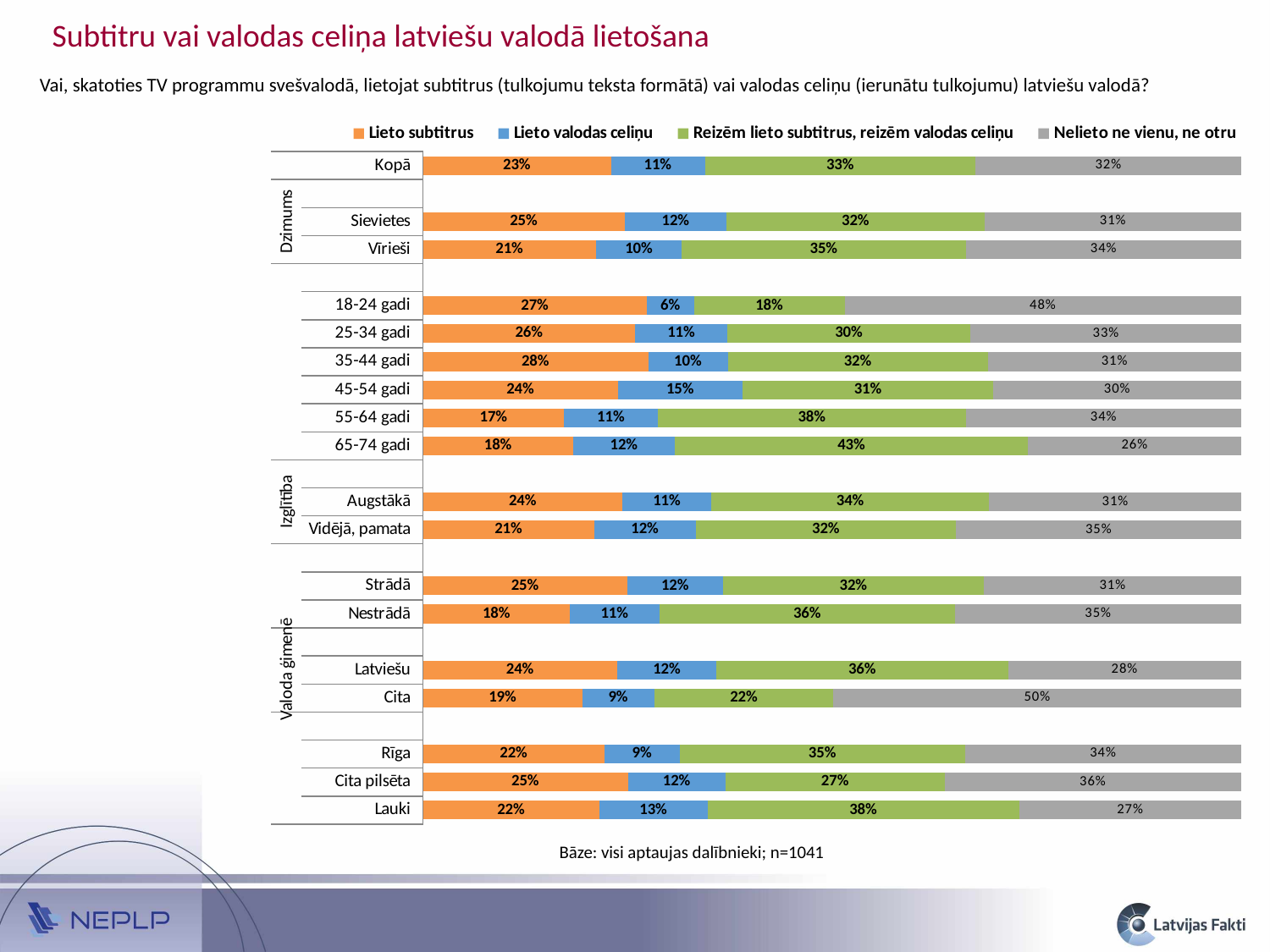
What is the value of 'Reizēm lieto subtitrus, reizēm valodas celiņu' for 65-74 gadi? 43% What kind of chart is shown on the slide? Stacked bar chart Which is larger: 'Reizēm lieto subtitrus, reizēm valodas celiņu' for Lauki or for Cita pilsēta? Lauki What is the first series listed in the legend? Lieto subtitrus Which category has the lowest value for 'Lieto valodas celiņu'? 18-24 gadi How many series does the legend list? 4 Which category has the highest value for 'Lieto subtitrus'? 35-44 gadi What is the value of 'Lieto subtitrus' for Kopā? 23% What is the value of 'Nelieto ne vienu, ne otru' for 18-24 gadi? 48% What is the value of 'Lieto valodas celiņu' for 45-54 gadi? 15% What is the difference between the 'Lieto subtitrus' values for Sievietes and Vīrieši? 4% Which category has the highest value for 'Nelieto ne vienu, ne otru'? Cita